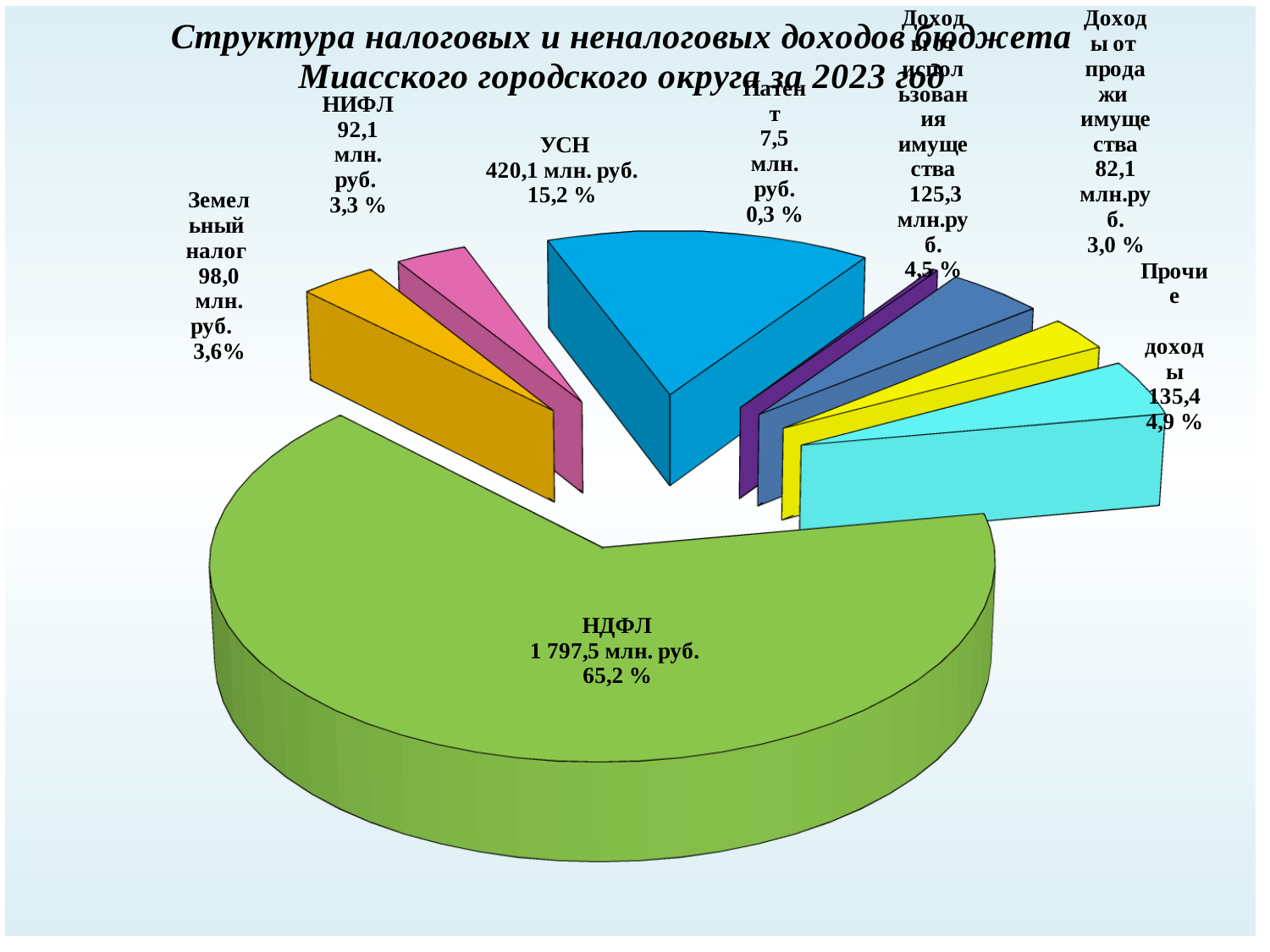
What is the difference between the values for УСН and Прочие доходы? 284,7 What is the value shown for УСН? 420,1 млн. руб. What is the value shown for НДФЛ? 1 797,5 млн. руб. What share of the pie does НДФЛ represent? 65,2 % Which is larger, the value for НИФЛ or the value for Доходы от использования имущества? Доходы от использования имущества Which category has the smallest slice of the pie? Патент What is the title of the chart? Структура налоговых и неналоговых доходов бюджета Миасского городского округа за 2023 год What kind of chart is shown on the slide? pie chart How many slices does the pie chart have? 8 What percentage is shown for Патент? 0,3 % What is the value shown for Земельный налог? 98,0 млн. руб. Which category has the largest slice of the pie? НДФЛ